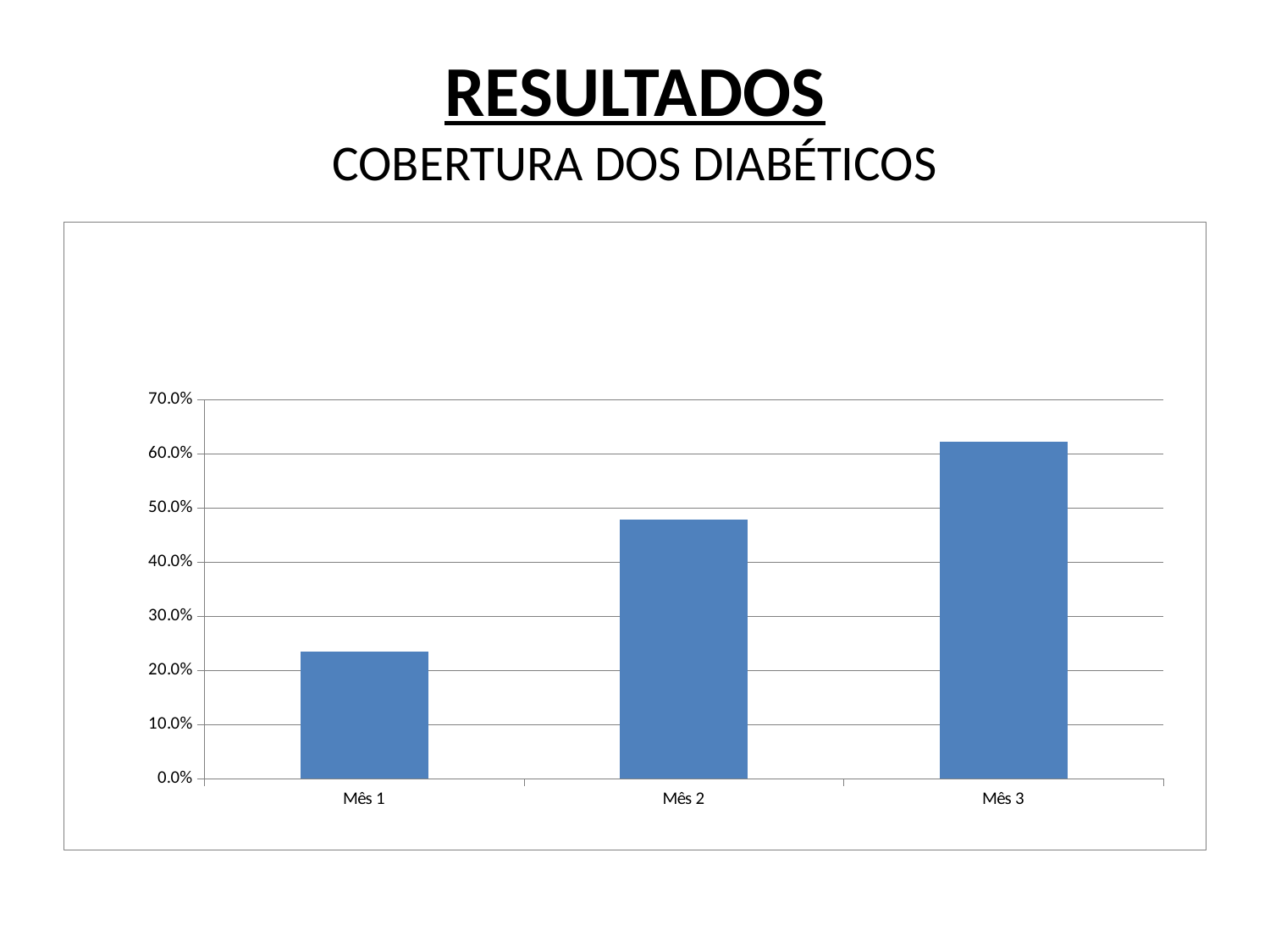
Is the value for Mês 3 greater or less than 60.0%? greater What kind of chart is shown on the slide? bar chart What is the highest value shown on the vertical axis? 70.0% Which month has the lowest value? Mês 1 Which month has the highest value? Mês 3 Is the value for Mês 2 greater or less than 50.0%? less Which is larger, the value for Mês 1 or the value for Mês 2? Mês 2 Is the value for Mês 1 greater or less than 30.0%? less What is the subtitle of the slide describing the chart? COBERTURA DOS DIABÉTICOS How many categories (months) are plotted on the chart? 3 Do the values rise or fall from Mês 1 to Mês 3? rise